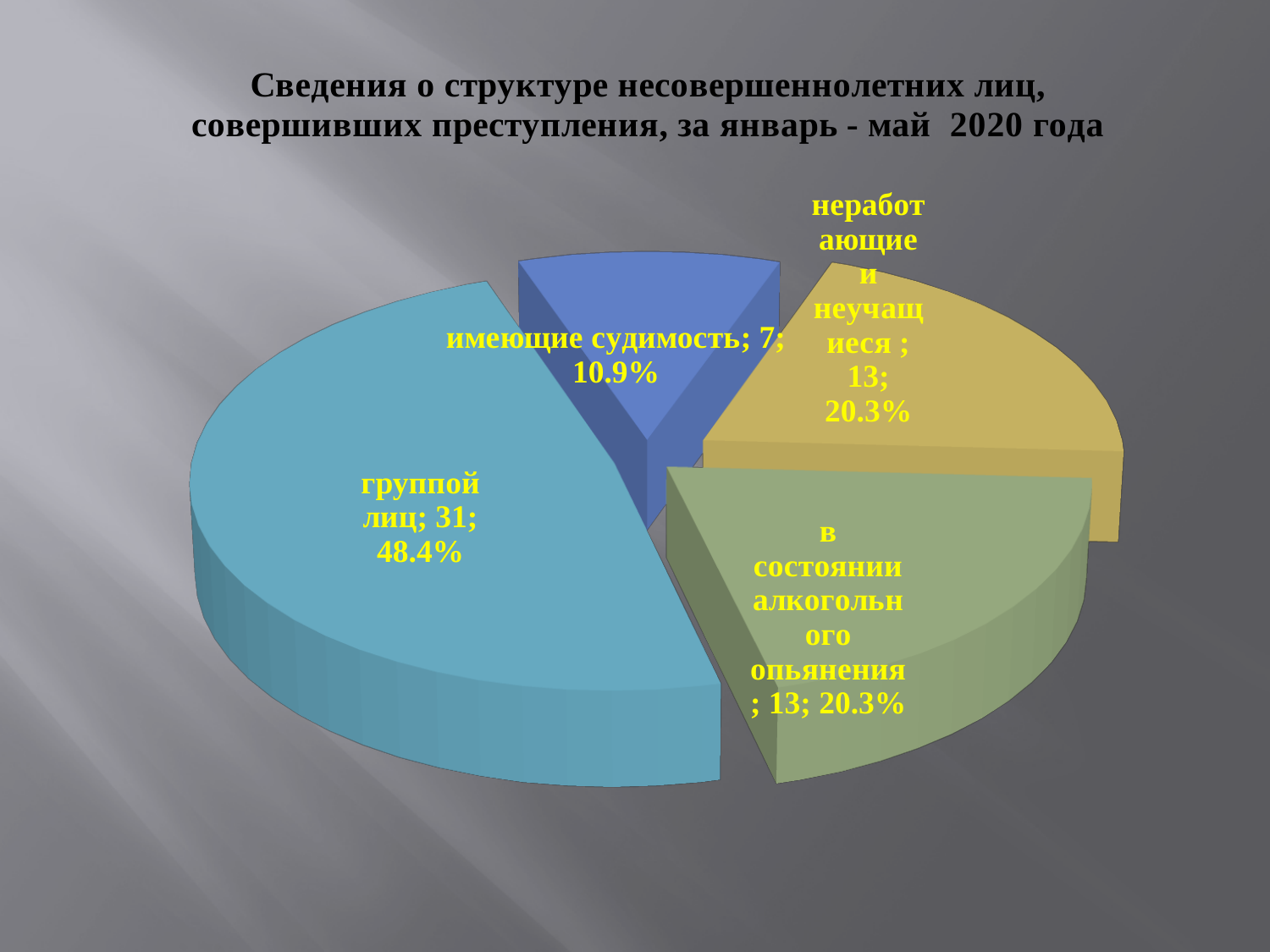
Which category has the smallest slice? имеющие судимость What is the value for "имеющие судимость"? 7 How many slices does the pie chart have? 4 Which category has the largest slice? группой лиц What is the value for "группой лиц"? 31 What is the value for "неработающие и неучащиеся"? 13 What kind of chart is shown on the slide? pie chart What share of the pie does "имеющие судимость" take? 10.9% What is the value for "в состоянии алкогольного опьянения"? 13 What is the difference between the values for "группой лиц" and "имеющие судимость"? 24 Which is larger, the value for "неработающие и неучащиеся" or the value for "имеющие судимость"? неработающие и неучащиеся What share of the pie does "группой лиц" take? 48.4%